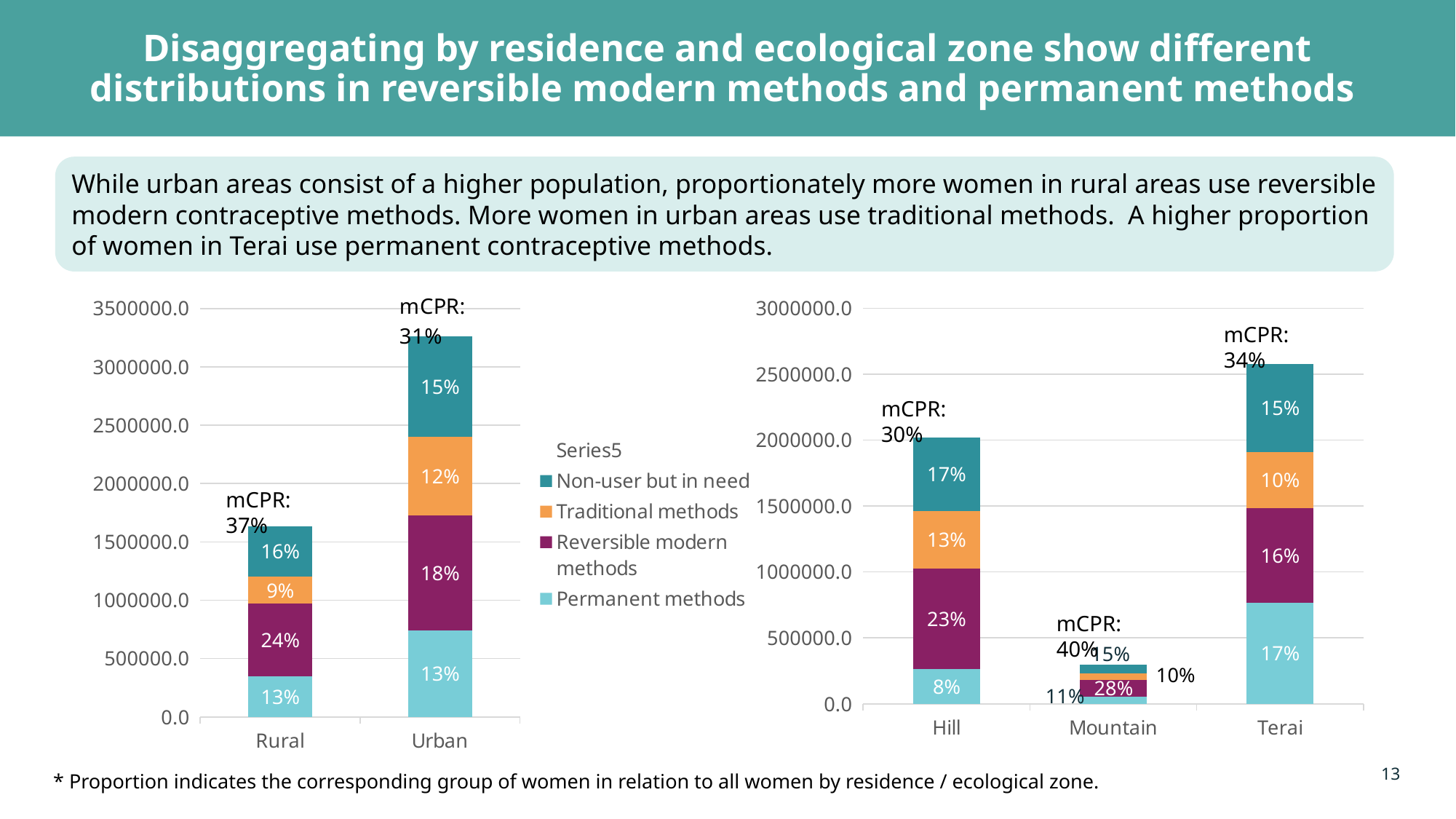
In the left chart, what is the mCPR shown for Rural? 37% In the left chart, is the total height of the Urban bar greater or less than 3000000? greater In the right chart, what is the value for Permanent methods in the Terai bar? 17% What kind of chart is used on this slide? Stacked bar chart In the right chart, which has the larger Reversible modern methods value, Hill or Terai? Hill In the right chart, which ecological zone has the tallest stacked bar? Terai In the left chart, what is the difference between the Reversible modern methods values for Rural and Urban? 6 percentage points In the left chart, which category has the taller stacked bar, Rural or Urban? Urban In the right chart, which ecological zone has the shortest stacked bar? Mountain In the left chart, what is the value for Traditional methods in the Urban bar? 12% In the right chart, what is the value for Permanent methods in the Hill bar? 8% In the left chart, what is the value for Reversible modern methods in the Rural bar? 24%